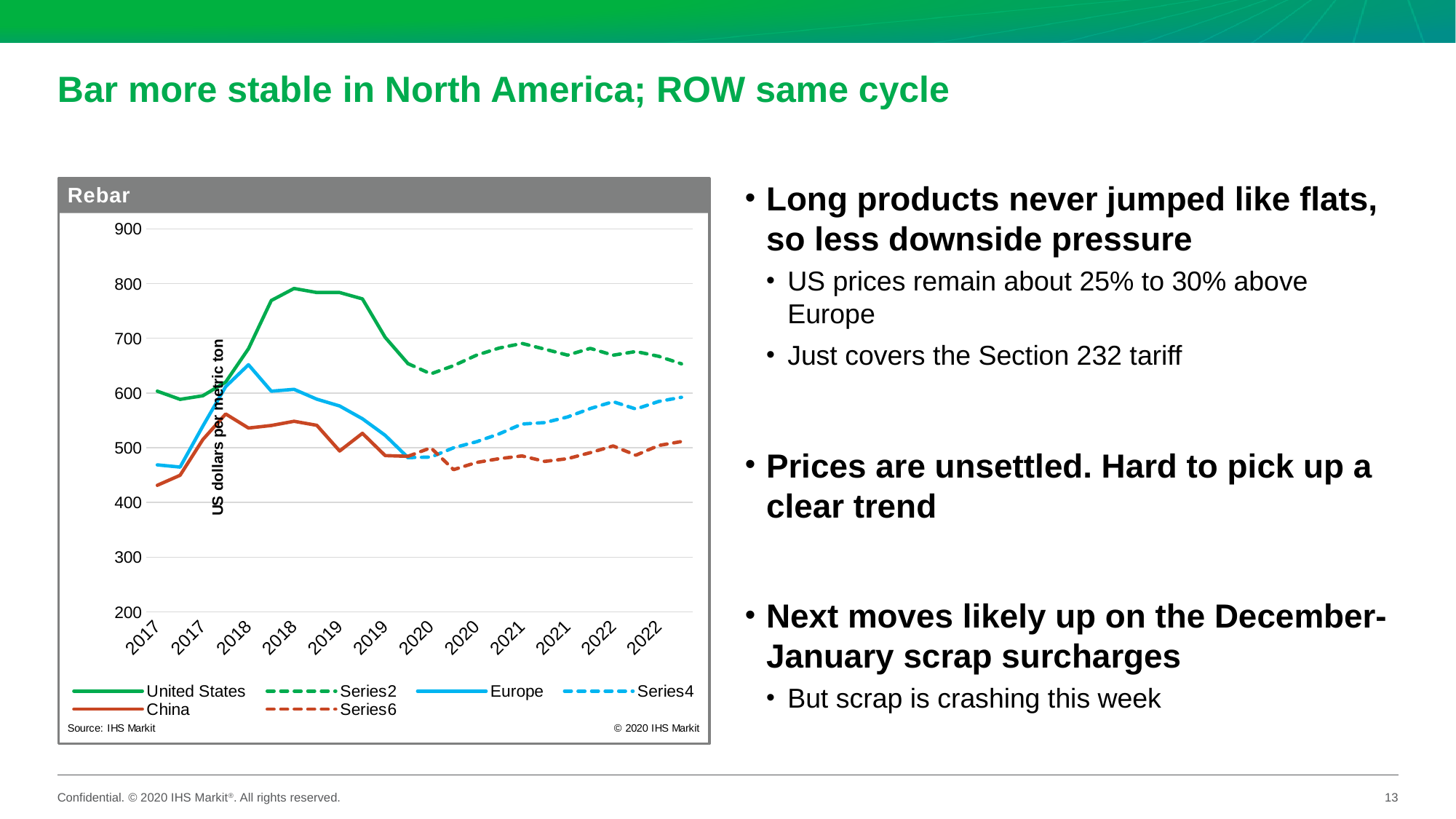
Which series has the lowest value at the start of the chart in 2017? China Which series reaches the highest value on the chart? United States Does the United States line rise or fall between 2019 and 2020? Fall Is the value for China at the start of 2017 greater or less than 500? less Is the value for Series2 in 2021 greater or less than 600? greater Is the peak value of the United States line greater or less than 700? greater Does the Series4 line rise or fall between 2020 and 2022? Rise How many series does the chart legend list? 6 What is the label on the vertical axis of the chart? US dollars per metric ton What kind of chart is shown on the slide? Line chart What is the title of the chart? Rebar Which is higher in 2018, the United States line or the China line? United States